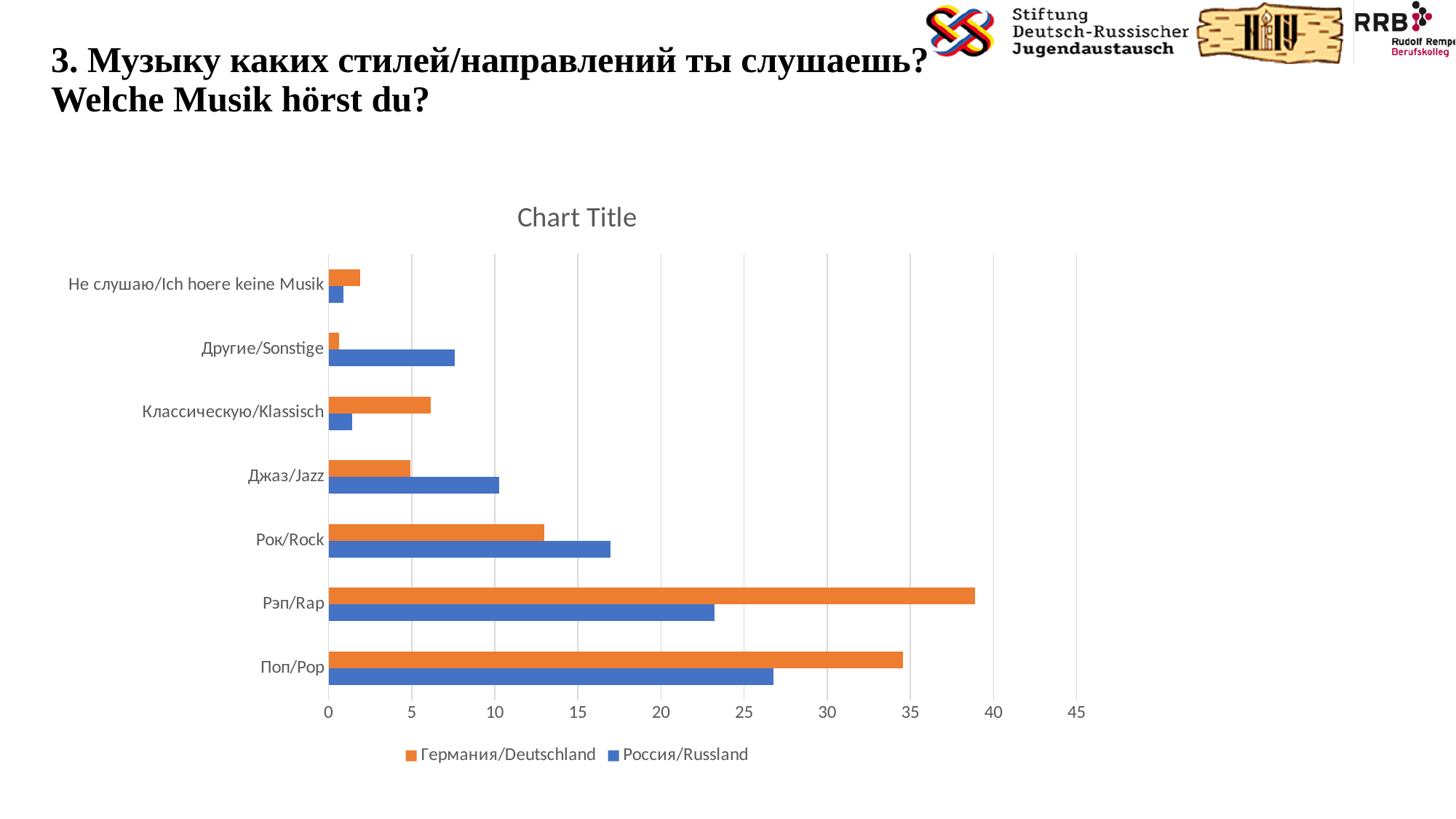
Is the value for Рок/Rock in the Германия/Deutschland series greater or less than 15? less For Рок/Rock, which series has the larger value, Германия/Deutschland or Россия/Russland? Россия/Russland Which category has the lowest value for Германия/Deutschland? Другие/Sonstige Which category has the highest value for Россия/Russland? Поп/Pop What kind of chart is shown on the slide? bar chart Which category has the highest value for Германия/Deutschland? Рэп/Rap How many series does the legend list? 2 How many music categories are shown on the chart? 7 What is the title shown above the chart? Chart Title For Поп/Pop, which series has the larger value, Германия/Deutschland or Россия/Russland? Германия/Deutschland Is the value for Рэп/Rap in the Германия/Deutschland series greater or less than 35? greater Which category has the lowest value for Россия/Russland? Не слушаю/Ich hoere keine Musik